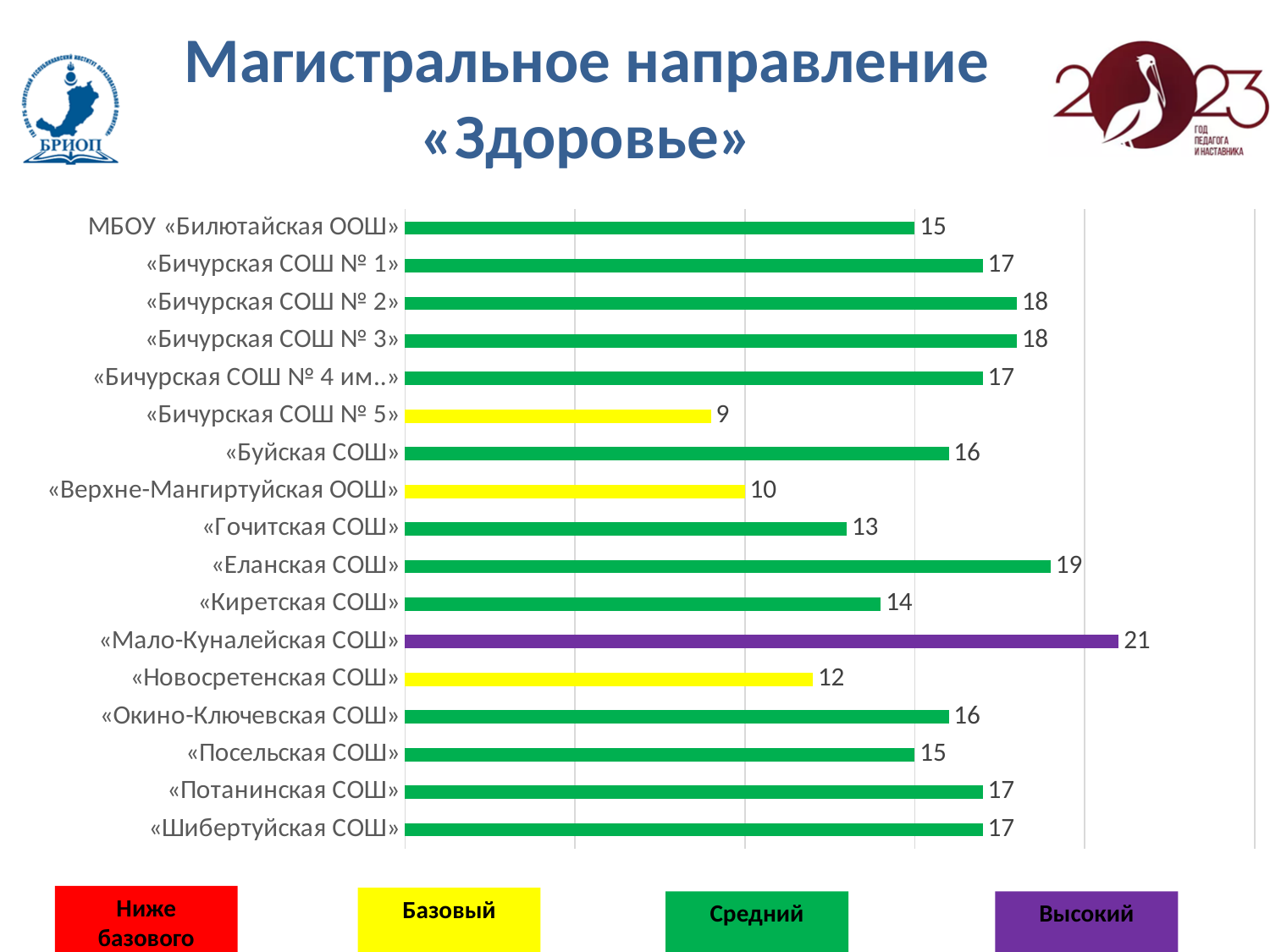
According to the legend at the bottom, which level does the purple colour represent? Высокий What is the difference between the values for «Мало-Куналейская СОШ» and «Бичурская СОШ № 5»? 12 Which school has the lowest value on the chart? «Бичурская СОШ № 5» What is the value for «Верхне-Мангиртуйская ООШ»? 10 Which school has the highest value on the chart? «Мало-Куналейская СОШ» What is the value for «Еланская СОШ»? 19 Which has a larger value, «Буйская СОШ» or «Новосретенская СОШ»? «Буйская СОШ» How many schools are shown on the chart? 17 What is the difference between the values for «Еланская СОШ» and «Киретская СОШ»? 5 What is the value for «Мало-Куналейская СОШ»? 21 What type of chart is shown on the slide? Bar chart What is the value for «Гочитская СОШ»? 13